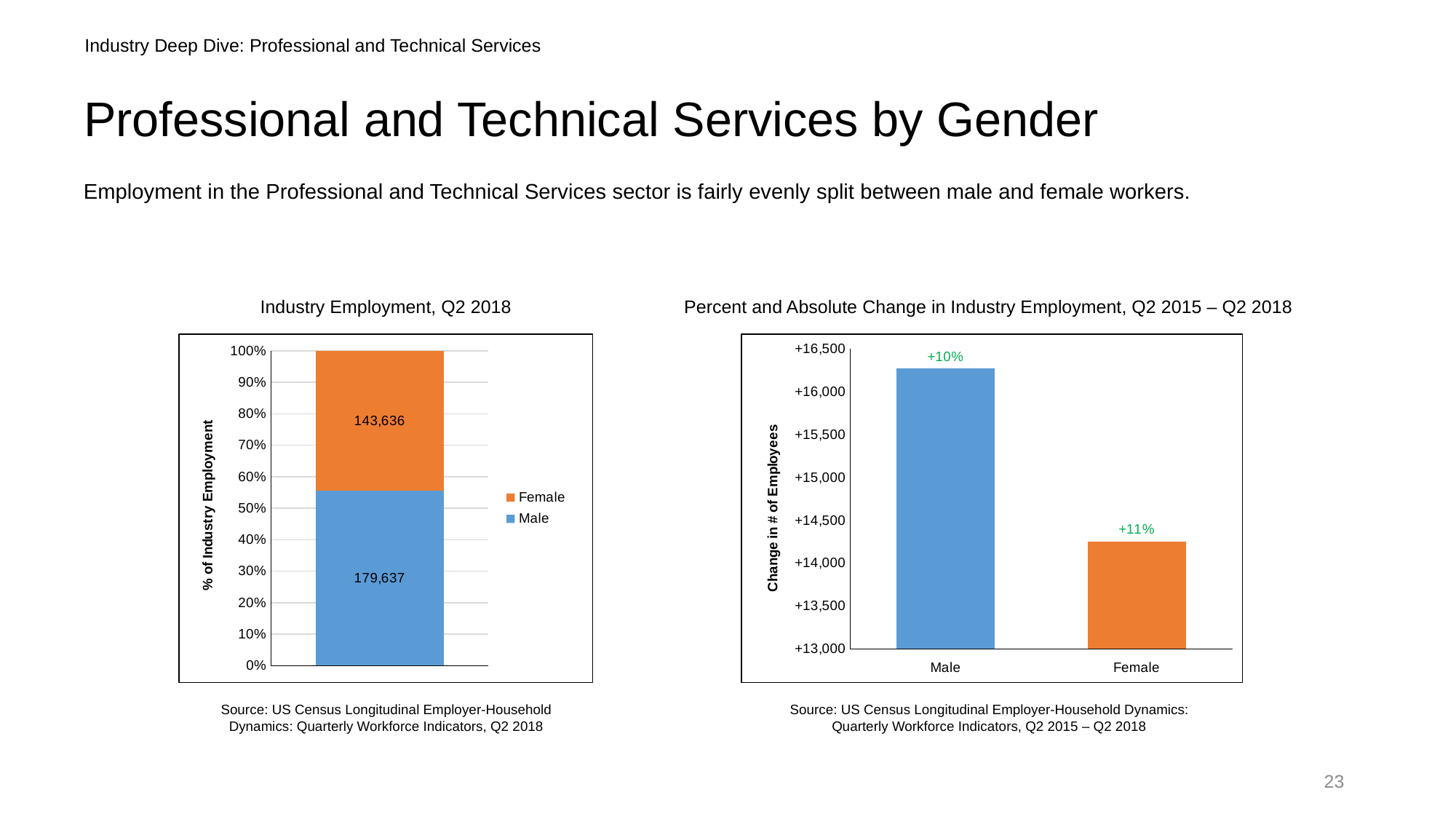
In the 'Percent and Absolute Change in Industry Employment, Q2 2015 – Q2 2018' chart, what percent change is labelled for Female? +11% In the 'Industry Employment, Q2 2018' chart, what is the value for Female? 143,636 In the 'Industry Employment, Q2 2018' chart, what is the value for Male? 179,637 In the 'Percent and Absolute Change in Industry Employment, Q2 2015 – Q2 2018' chart, what percent change is labelled for Male? +10% In the 'Percent and Absolute Change in Industry Employment, Q2 2015 – Q2 2018' chart, which category has the taller bar? Male In the 'Percent and Absolute Change in Industry Employment, Q2 2015 – Q2 2018' chart, is the value for Male greater or less than +16,000? greater In the 'Industry Employment, Q2 2018' chart, which series has the larger value, Male or Female? Male In the 'Percent and Absolute Change in Industry Employment, Q2 2015 – Q2 2018' chart, is the value for Female greater or less than +14,500? less How many series does the legend of the 'Industry Employment, Q2 2018' chart list? 2 What kind of chart is the 'Industry Employment, Q2 2018' chart? Stacked bar chart In the 'Industry Employment, Q2 2018' chart, what is the difference between the Male and Female values? 36,001 In the 'Industry Employment, Q2 2018' chart, what is the total of the stacked bar? 323,273